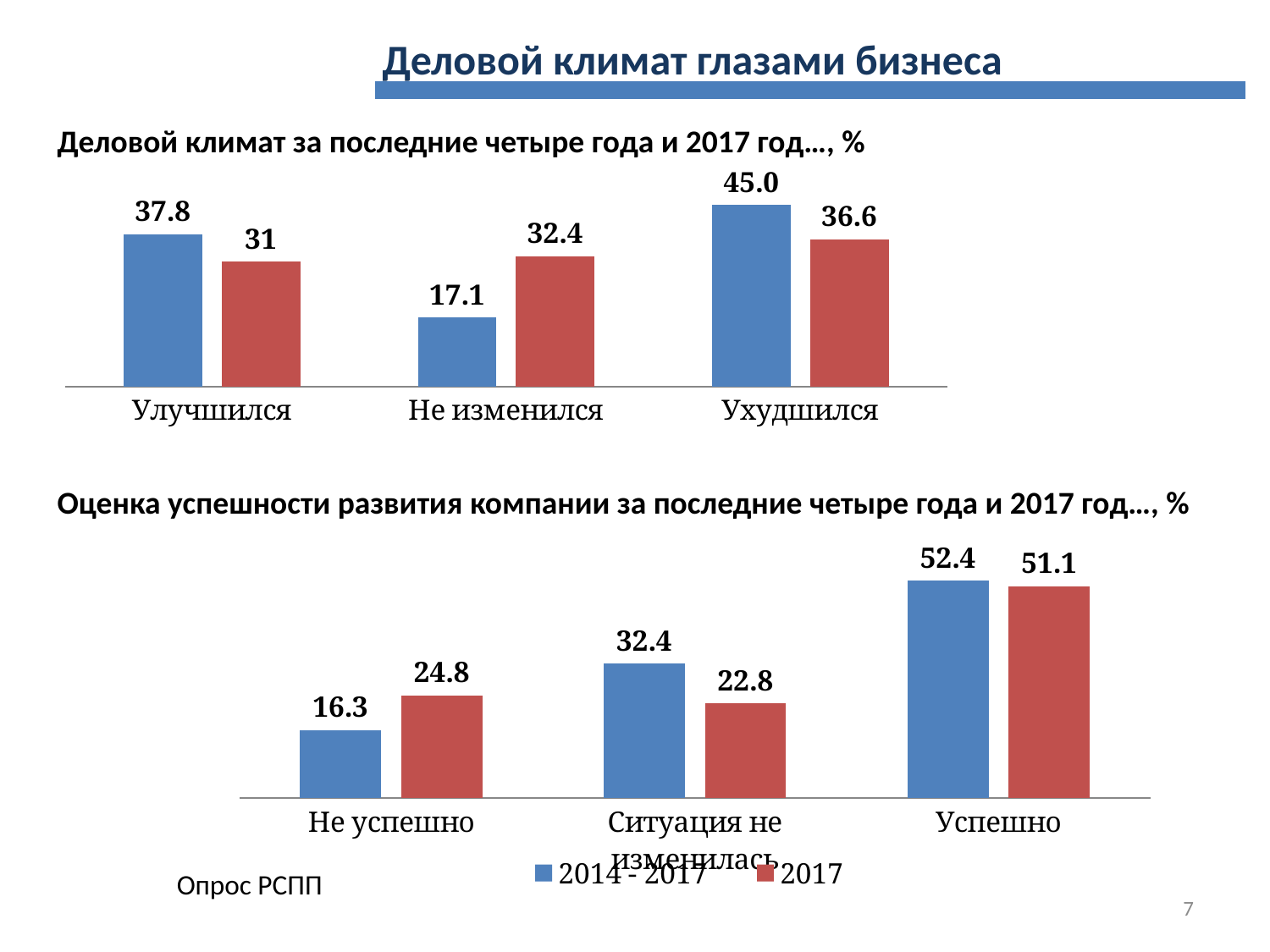
In the top chart (Деловой климат за последние четыре года и 2017 год…), what is the value for Не изменился in the 2017 series? 32.4 In the bottom chart (Оценка успешности развития компании…), what is the value for Не успешно in the 2014 - 2017 series? 16.3 In the top chart (Деловой климат за последние четыре года и 2017 год…), what is the difference between the 2014 - 2017 and 2017 values for Ухудшился? 8.4 In the bottom chart (Оценка успешности развития компании…), what is the value for Успешно in the 2017 series? 51.1 In the bottom chart (Оценка успешности развития компании…), which category has the highest value in the 2017 series? Успешно In the top chart (Деловой климат за последние четыре года и 2017 год…), which category has the highest value in the 2014 - 2017 series? Ухудшился In the bottom chart (Оценка успешности развития компании…), what is the difference between the 2014 - 2017 and 2017 values for Ситуация не изменилась? 9.6 In the top chart (Деловой климат за последние четыре года и 2017 год…), what is the value for Улучшился in the 2014 - 2017 series? 37.8 In the top chart (Деловой климат за последние четыре года и 2017 год…), which is larger for Не изменился: the 2014 - 2017 value or the 2017 value? 2017 In the top chart (Деловой климат за последние четыре года и 2017 год…), which category has the lowest value in the 2014 - 2017 series? Не изменился What type of chart is the top chart (Деловой климат за последние четыре года и 2017 год…)? Bar chart How many categories are shown in the bottom chart (Оценка успешности развития компании…)? 3